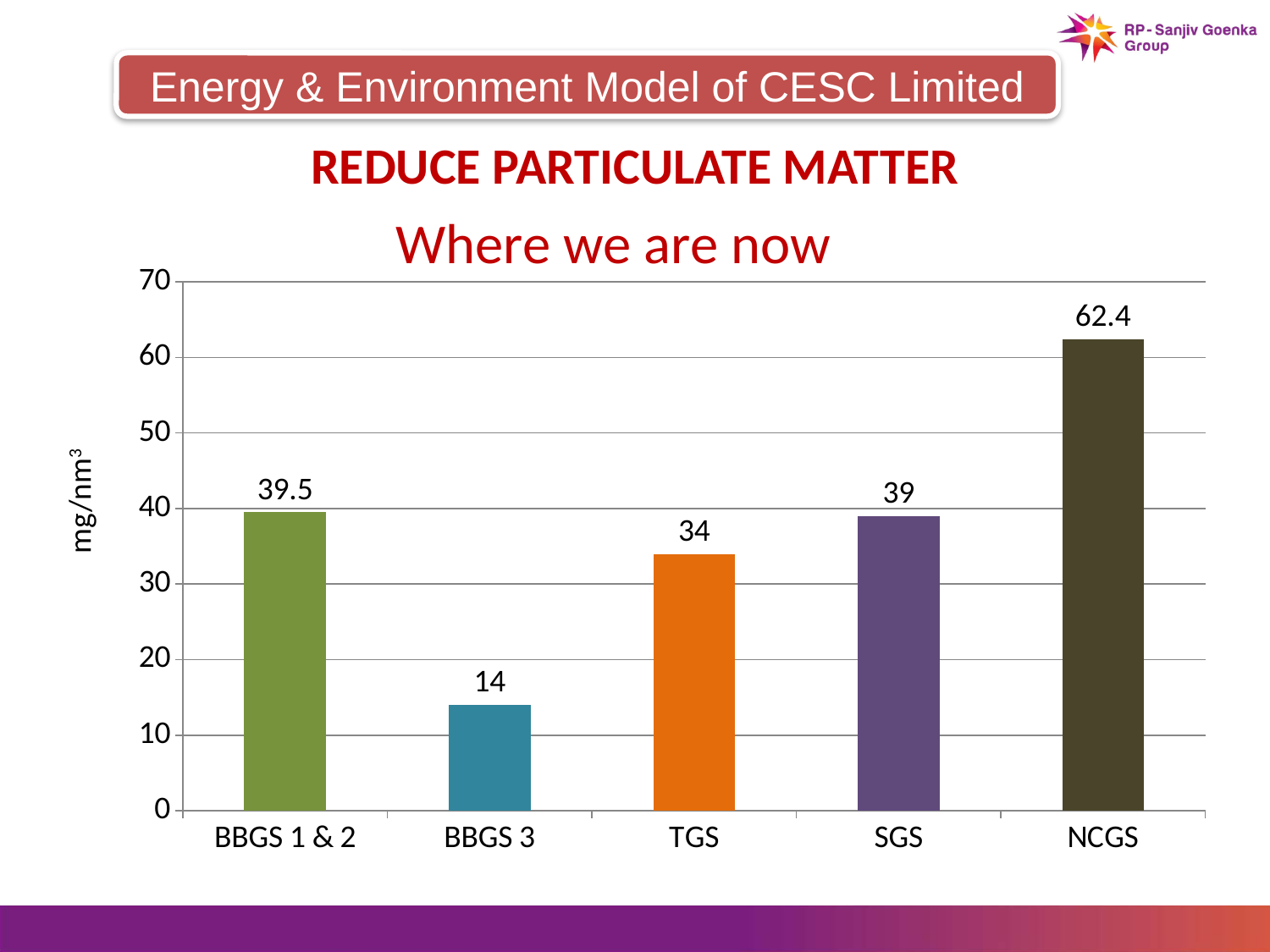
What is the difference between the values for NCGS and BBGS 3? 48.4 What is the value shown for BBGS 3? 14 Which station has the highest particulate matter value? NCGS Which station has the lowest particulate matter value? BBGS 3 What unit is shown on the vertical axis of the chart? mg/nm³ Is the value for NCGS greater or less than 60? greater How many stations are shown on the chart? 5 What type of chart is shown on the slide? Bar chart What is the value shown for NCGS? 62.4 What is the particulate matter value for BBGS 1 & 2? 39.5 What is the difference between the values for BBGS 1 & 2 and SGS? 0.5 Which is larger, the value for TGS or the value for SGS? SGS